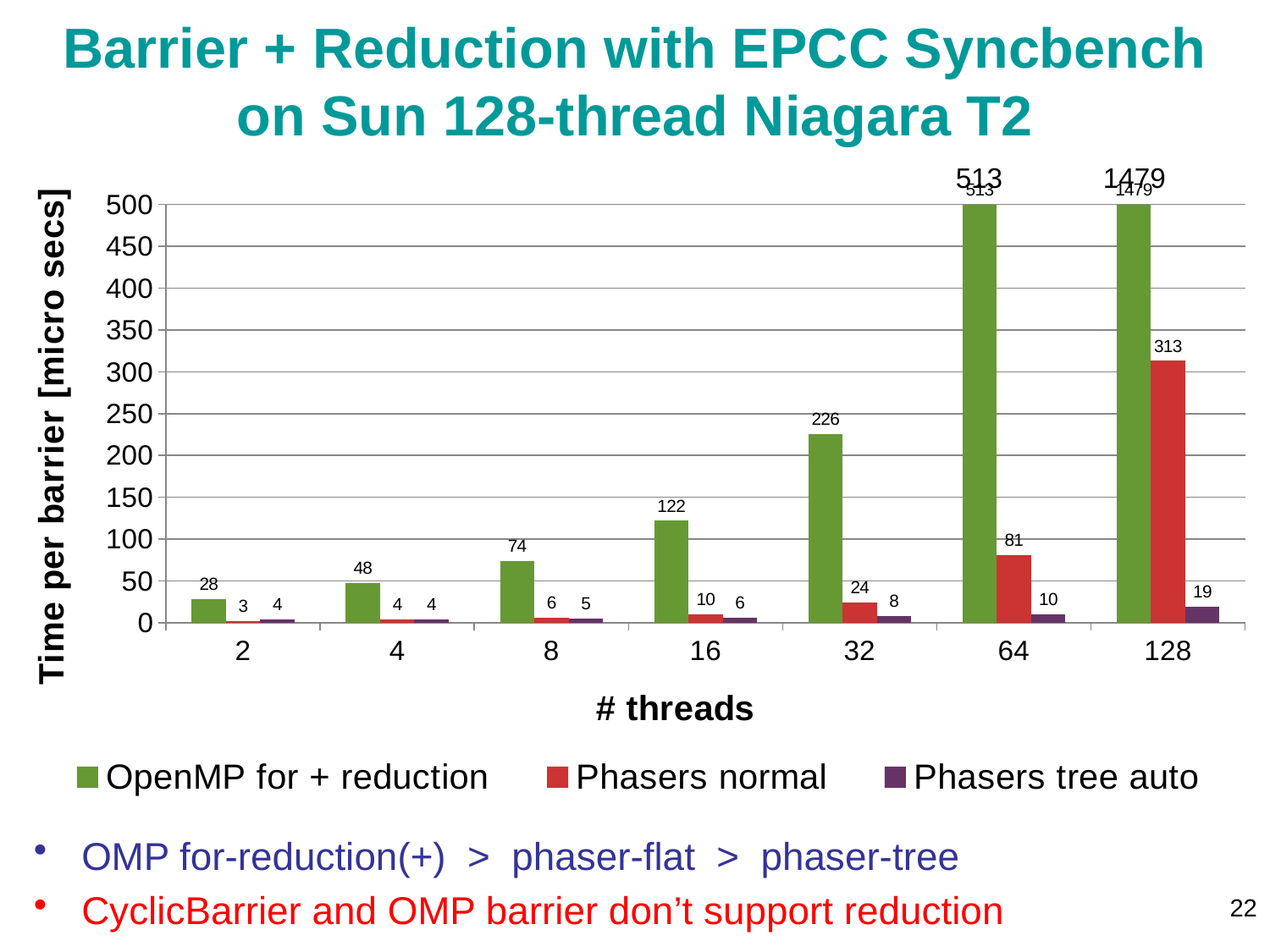
Which is larger at 16 threads: Phasers normal or Phasers tree auto? Phasers normal At which thread count is the OpenMP for + reduction value highest? 128 What is the value for Phasers normal at 128 threads? 313 What kind of chart is shown on the slide? Bar chart What is the difference between OpenMP for + reduction and Phasers normal at 64 threads? 432 What is the value for OpenMP for + reduction at 32 threads? 226 Do the OpenMP for + reduction values rise or fall as the number of threads increases? Rise What is the value for OpenMP for + reduction at 128 threads? 1479 At which thread count is the Phasers normal value lowest? 2 What is the value for Phasers tree auto at 64 threads? 10 How many series does the legend list? 3 How many thread counts are shown on the x axis? 7